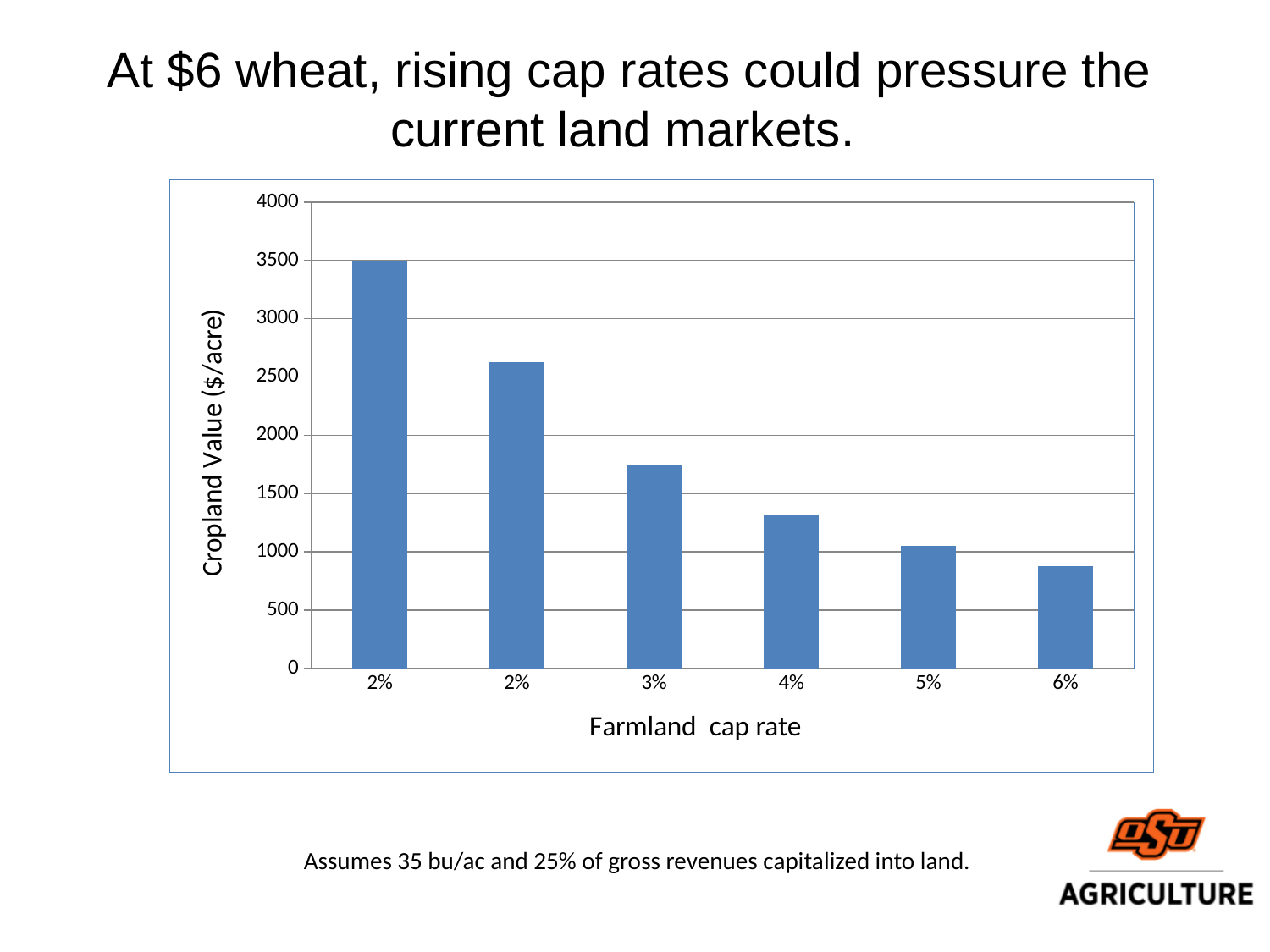
What is the label on the horizontal axis of the chart? Farmland cap rate Do cropland values rise or fall as the farmland cap rate increases along the x axis? fall Which farmland cap rate has the lowest cropland value? 6% What is the label on the vertical axis of the chart? Cropland Value ($/acre) Which has a larger cropland value, the 3% cap rate or the 5% cap rate? 3% Is the cropland value at a 4% cap rate greater or less than 1500? less Which bar has the highest cropland value? the leftmost bar (2%) Is the cropland value at a 6% cap rate greater or less than 1000? less Is the cropland value at a 3% cap rate greater or less than 1500? greater How many bars are plotted in the chart? 6 What kind of chart is shown on the slide? bar chart What is the cropland value for the leftmost bar (2% cap rate)? 3500